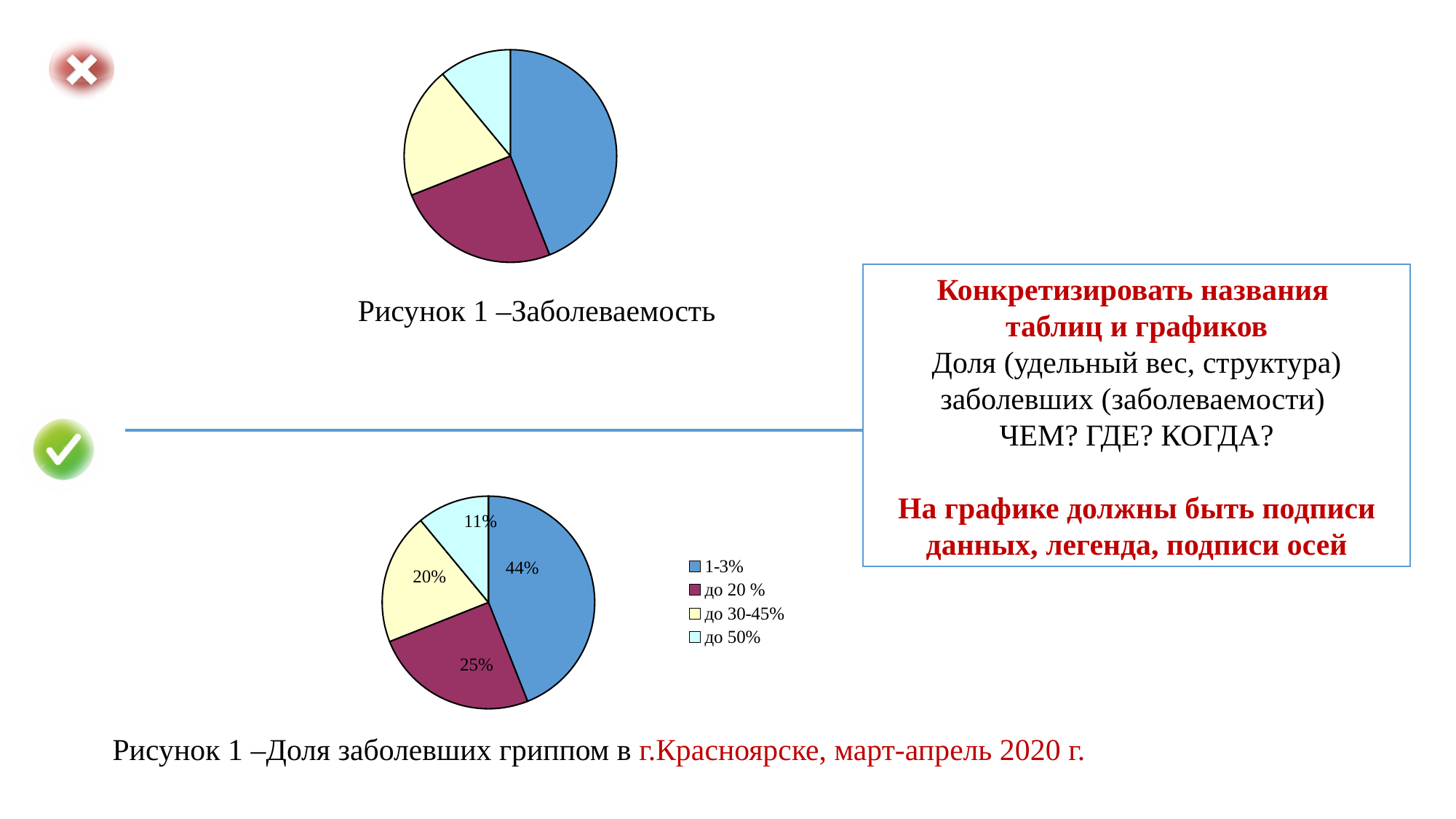
In the bottom chart, which category has the largest share? 1-3% In the bottom chart, which category has the smallest share? до 50% What is the caption of the bottom chart? Рисунок 1 – Доля заболевших гриппом в г.Красноярске, март-апрель 2020 г. In the bottom chart, what is the difference in percentage points between the '1-3%' slice and the 'до 20 %' slice? 19 In the bottom chart, which is larger: the share for 'до 30-45%' or the share for 'до 50%'? до 30-45% How many slices does the top pie chart have? 4 How many categories does the legend of the bottom chart list? 4 In the bottom chart, what share is shown for the category 'до 30-45%'? 20% In the bottom chart, what share is shown for the category 'до 50%'? 11% In the bottom chart, what share is shown for the category 'до 20 %'? 25% In the bottom chart (Рисунок 1 – Доля заболевших гриппом в г.Красноярске), what share is labelled for the category '1-3%'? 44% What kind of chart is the top chart on the slide? Pie chart